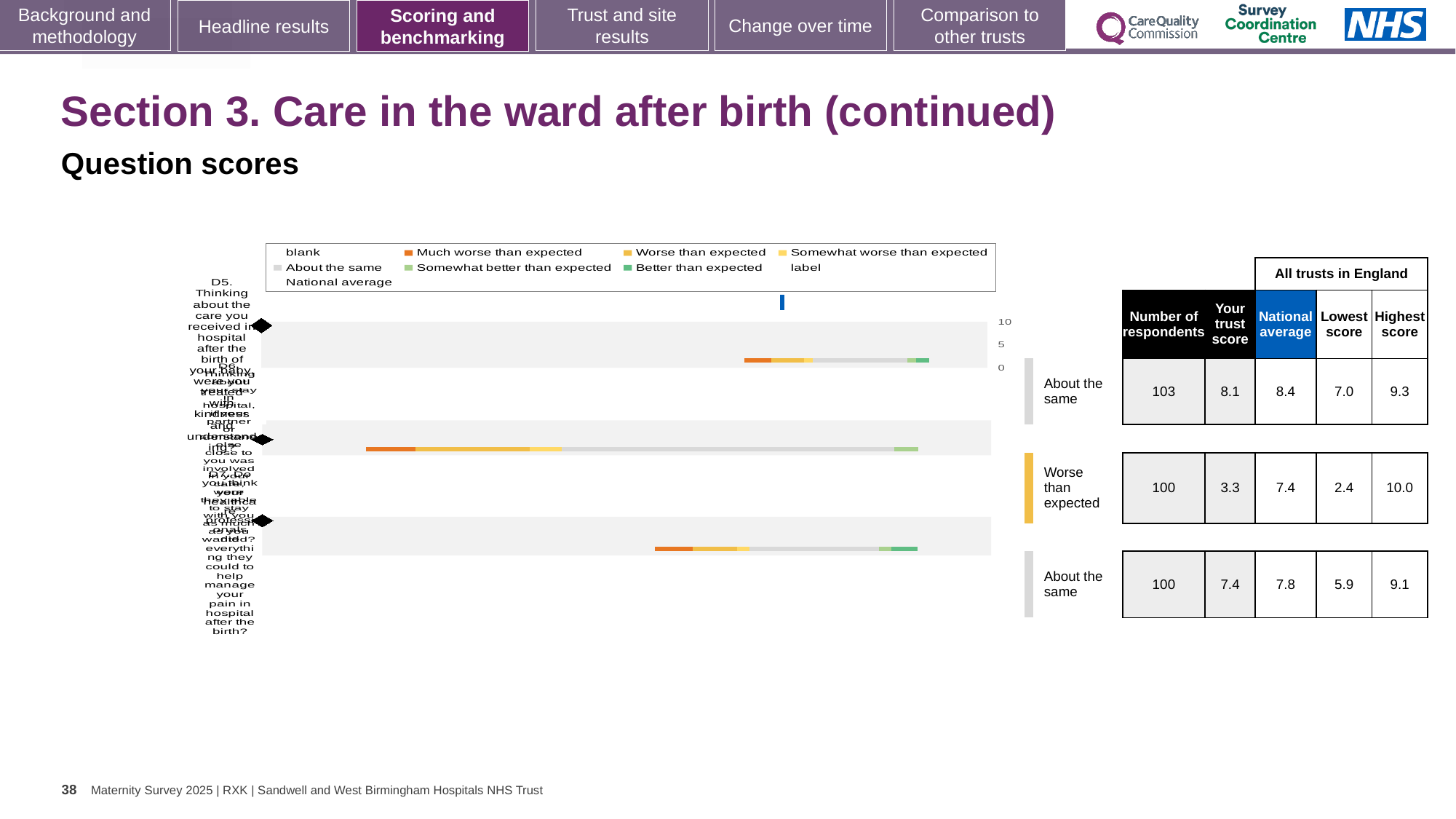
In the benchmark table next to the chart, what is 'Your trust score' for the row rated 'Worse than expected'? 3.3 In the benchmark table next to the chart, is the trust score for the row rated 'Worse than expected' larger or smaller than its national average? smaller What colour represents 'Much worse than expected' in the chart legend? orange In the benchmark table next to the chart, what is the national average for the third row? 7.8 In the benchmark table next to the chart, what is the lowest score for the row rated 'Worse than expected'? 2.4 In the benchmark table next to the chart, which row has the highest 'Your trust score'? the first row (8.1) In the benchmark table next to the chart, what is the difference between the national average and the trust score for the row rated 'Worse than expected'? 4.1 In the benchmark table next to the chart, what is the number of respondents for the first row (rated 'About the same')? 103 What kind of chart is shown on the slide? bar chart How many entries does the chart legend list? 9 How many question rows are plotted in the chart? 3 What colour represents 'Better than expected' in the chart legend? green